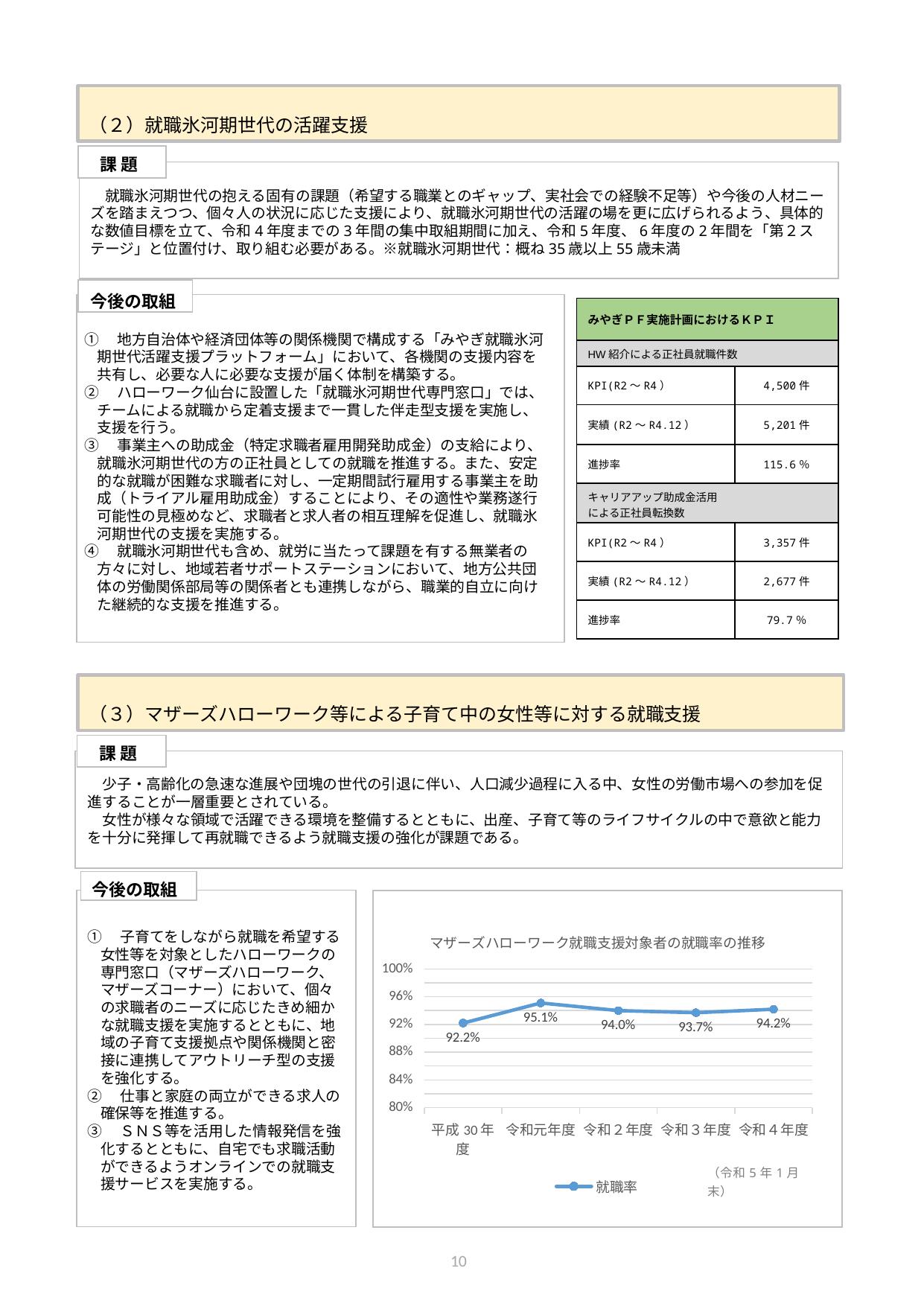
How many fiscal years are plotted in the chart? 5 Which fiscal year has the lowest employment rate in the chart? 平成30年度 Is the employment rate for 令和3年度 greater or less than 92%? greater What kind of chart is shown on the slide? line chart What is the employment rate (就職率) for 平成30年度 in the chart? 92.2% What is the title of the chart on the slide? マザーズハローワーク就職支援対象者の就職率の推移 What is the difference in employment rate between 令和元年度 and 平成30年度? 2.9% How many series does the chart legend list? 1 What is the employment rate (就職率) for 令和4年度 in the chart? 94.2% Which fiscal year has the highest employment rate in the chart? 令和元年度 Which has a higher employment rate, 令和2年度 or 令和3年度? 令和2年度 What is the employment rate (就職率) for 令和元年度 in the chart? 95.1%